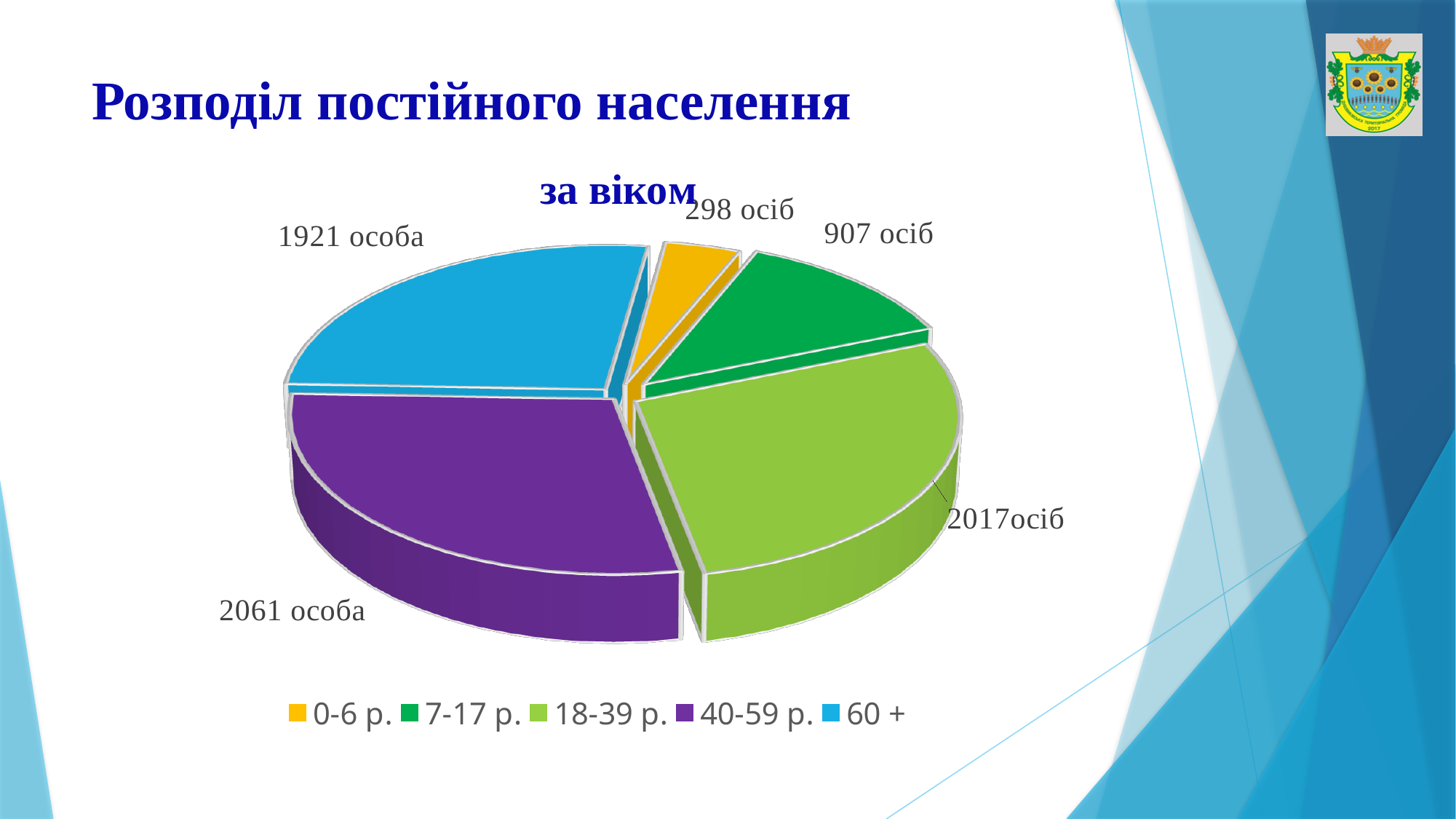
What colour is the 40-59 р. slice? purple What kind of chart is shown on the slide? pie chart Which age group has the largest slice? 40-59 р. How many age groups does the legend list? 5 What is the value shown for the 0-6 р. slice? 298 осіб What is the total of all slices in the pie chart? 7204 Which age group has the smallest slice? 0-6 р. What is the value shown for the 18-39 р. slice? 2017осіб Which is larger, the value for 60 + or the value for 7-17 р.? 60 + What is the difference between the 40-59 р. value and the 18-39 р. value? 44 What is the value shown for the 60 + slice? 1921 особа What is the value shown for the 7-17 р. slice? 907 осіб